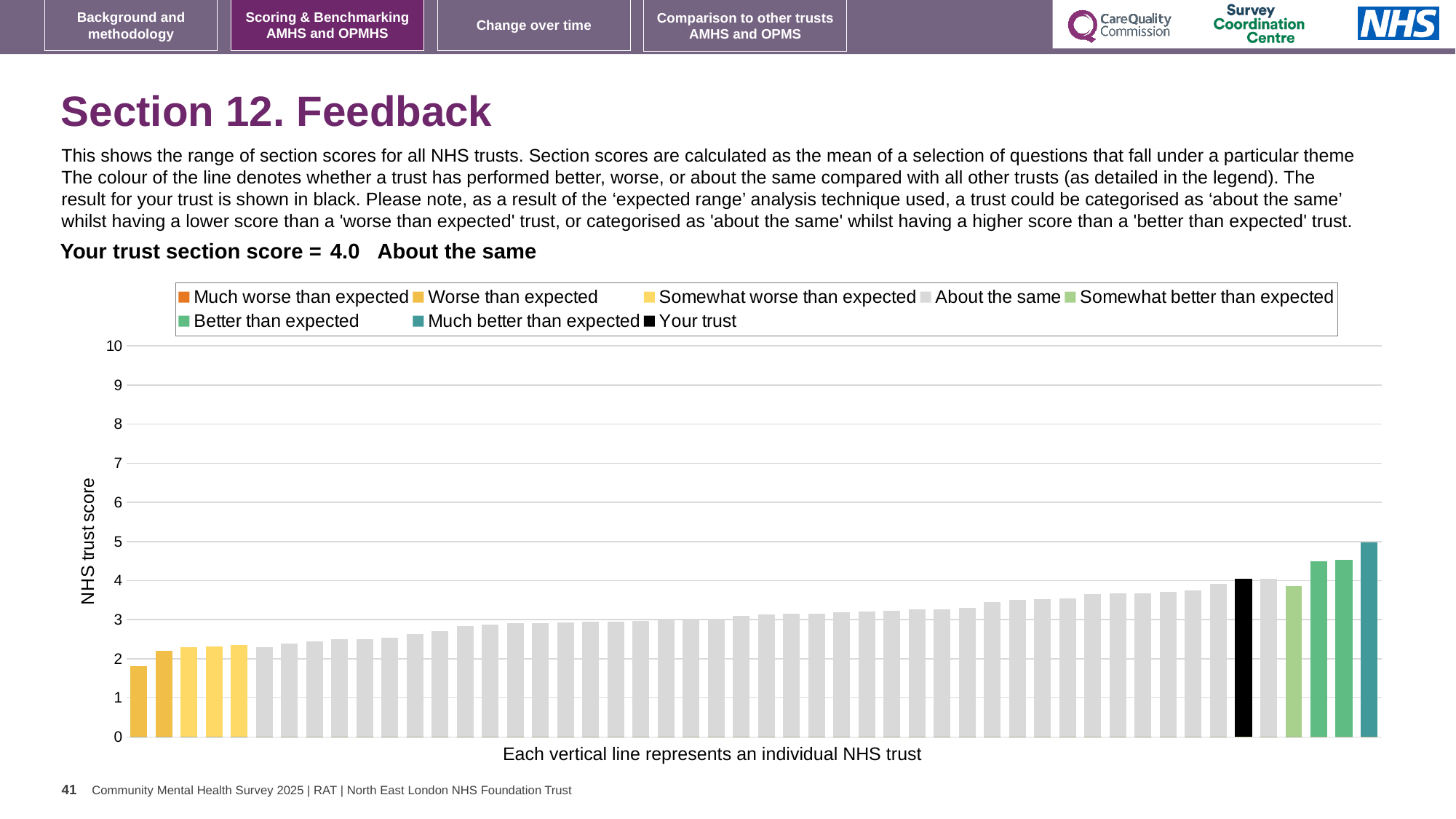
What is the section score for your trust shown on the slide? 4.0 Is the value of the shortest bar greater or less than 2? less Do the bar values rise or fall from left to right along the x axis? rise What colour is used for the 'Your trust' bar in the chart? black What is the label on the vertical axis of the chart? NHS trust score Is the value of the tallest bar greater or less than 4? greater What kind of chart is shown on the slide? bar chart How many entries does the chart legend list? 8 Which legend category does the tallest bar belong to? Much better than expected How many bars are coloured as 'Better than expected'? 2 Is the value of the black 'Your trust' bar greater or less than 3? greater How many bars are coloured as 'Much better than expected'? 1